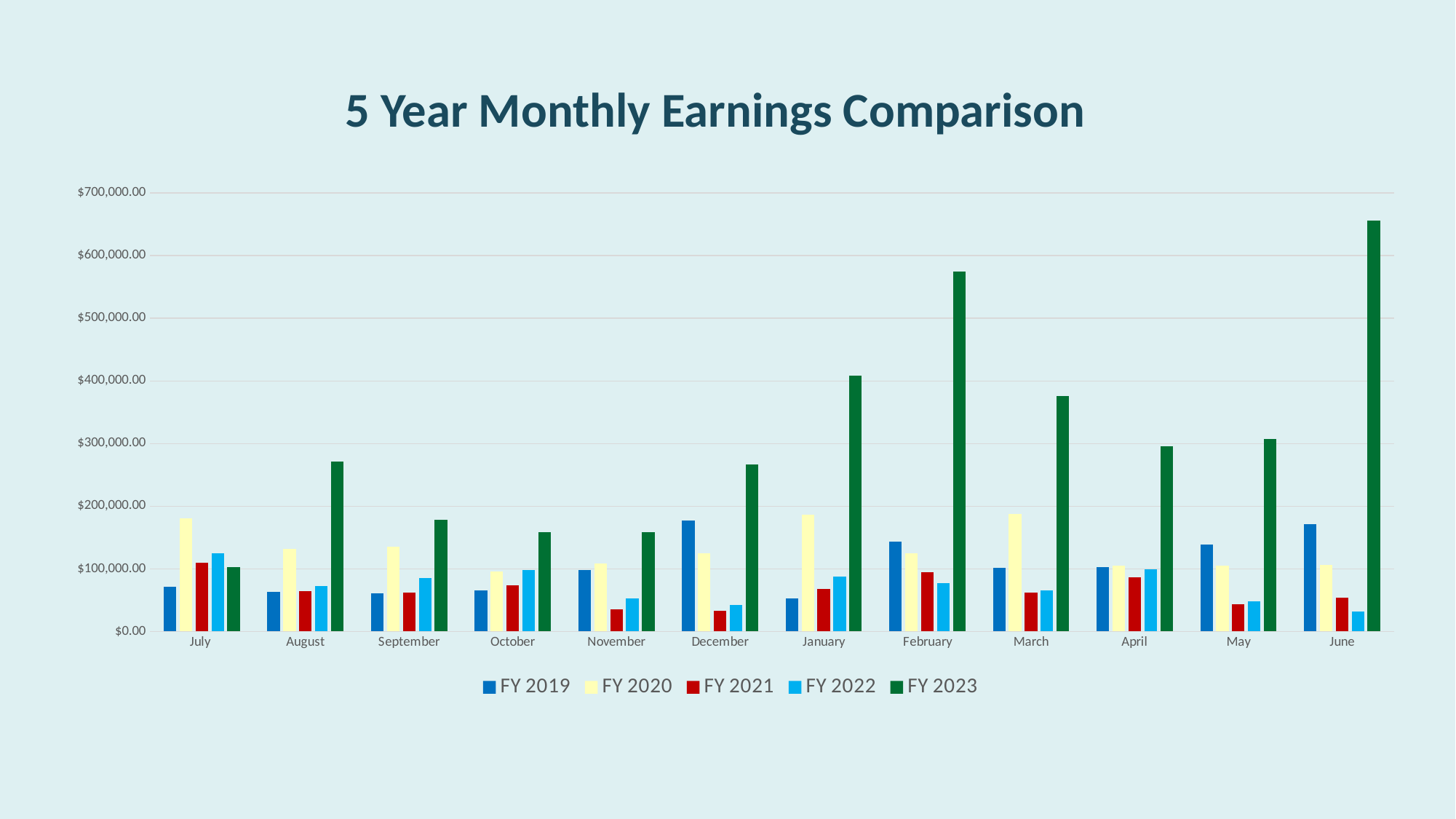
In July, which is larger: FY 2020 or FY 2023? FY 2020 In which month is the FY 2023 value lowest? July Is the FY 2023 value for August greater or less than $300,000.00? less Which is larger for FY 2023: February or March? February How many series does the legend list? 5 In which month is the FY 2023 value highest? June What is the title of the chart? 5 Year Monthly Earnings Comparison Is the FY 2019 value for December greater or less than $100,000.00? greater Is the FY 2023 value for June greater or less than $600,000.00? greater What kind of chart is shown on the slide? Bar chart In which month is the FY 2021 value highest? July How many months are shown on the x axis? 12